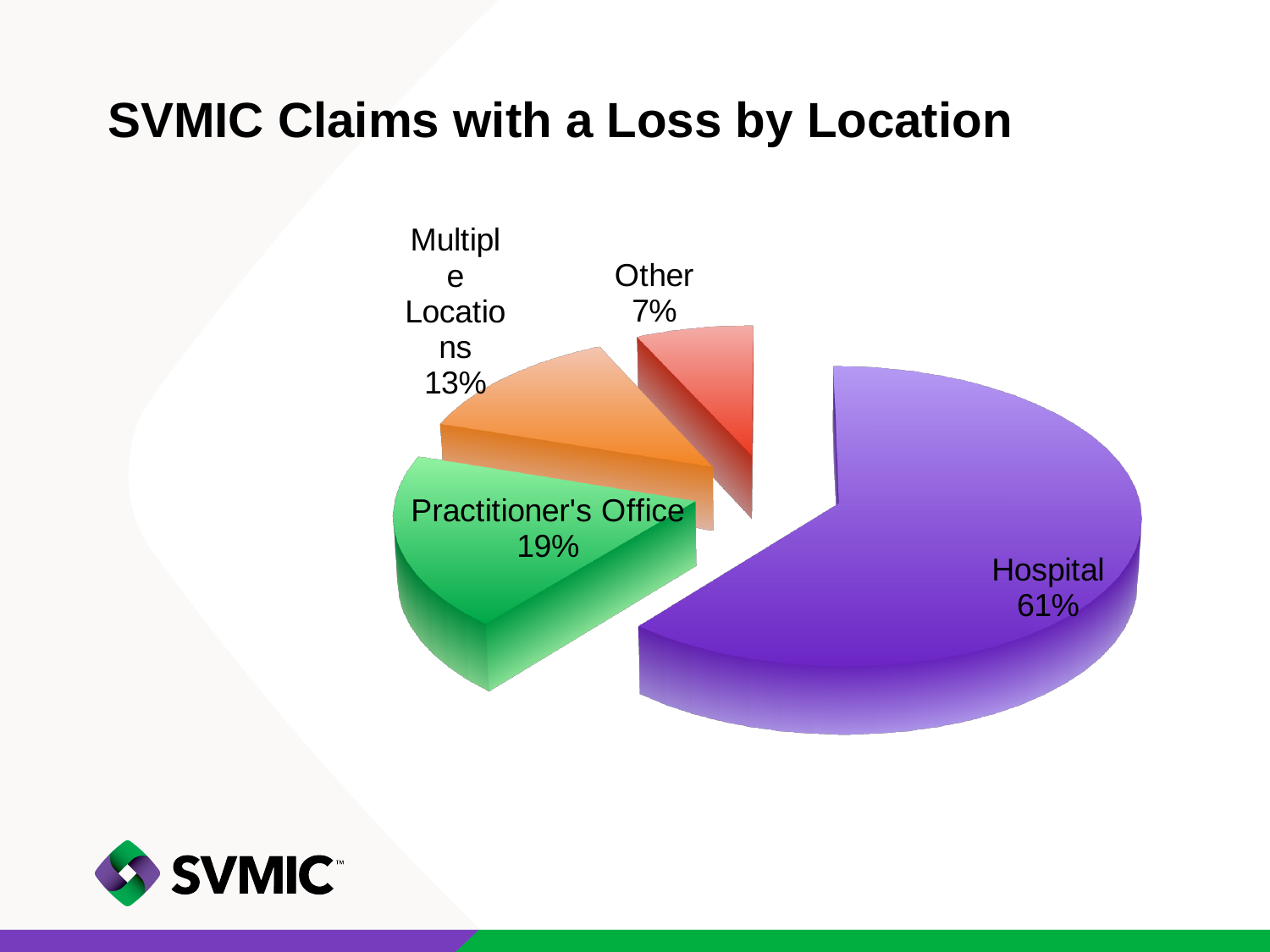
Which has a larger share of claims with a loss, Practitioner's Office or Multiple Locations? Practitioner's Office What percentage of claims with a loss falls under Other? 7% Which location has the largest share of claims with a loss? Hospital What is the difference in percentage points between Multiple Locations and Other? 6 What share of SVMIC claims with a loss occurred in a Hospital? 61% What type of chart is used on this slide? Pie chart How many location categories are shown in the pie chart? 4 What share of claims with a loss is labelled Multiple Locations? 13% What percentage of claims with a loss is attributed to Practitioner's Office? 19% Which location has the smallest share of claims with a loss? Other How many percentage points larger is the Hospital share than the Practitioner's Office share? 42 What is the title of the chart on this slide? SVMIC Claims with a Loss by Location